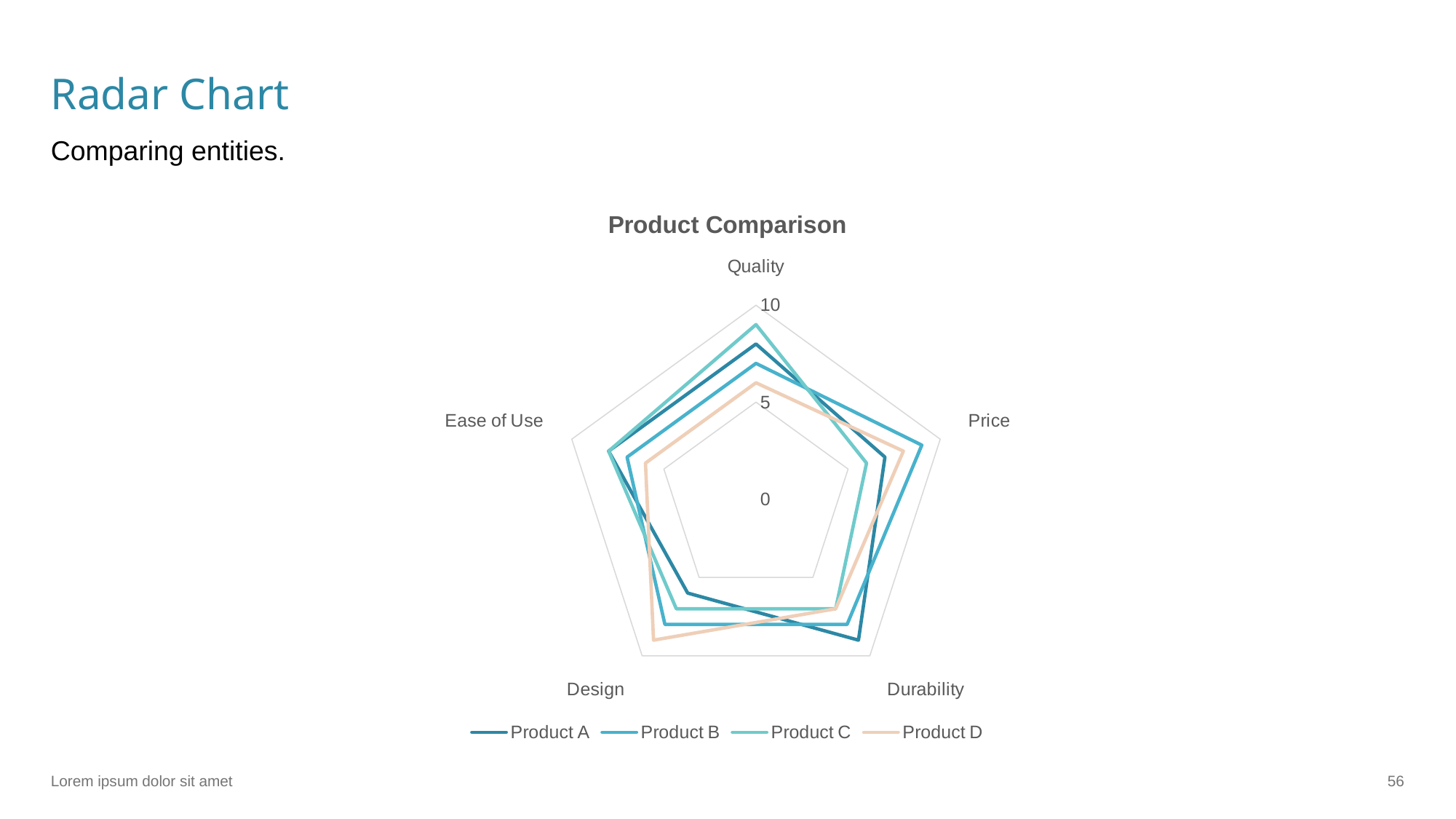
Is the value of Product A for Quality greater or less than 5? greater What kind of chart is shown on the slide? Radar chart Which is larger for Design: Product A or Product B? Product B Which is larger for Price: Product B or Product C? Product B How many series does the legend list? 4 Which product has the highest value for Quality? Product C What is the title of the chart? Product Comparison Which product has the lowest value for Quality? Product D Which product has the lowest value for Price? Product C Which product has the lowest value for Ease of Use? Product D How many categories (axes) does the radar chart have? 5